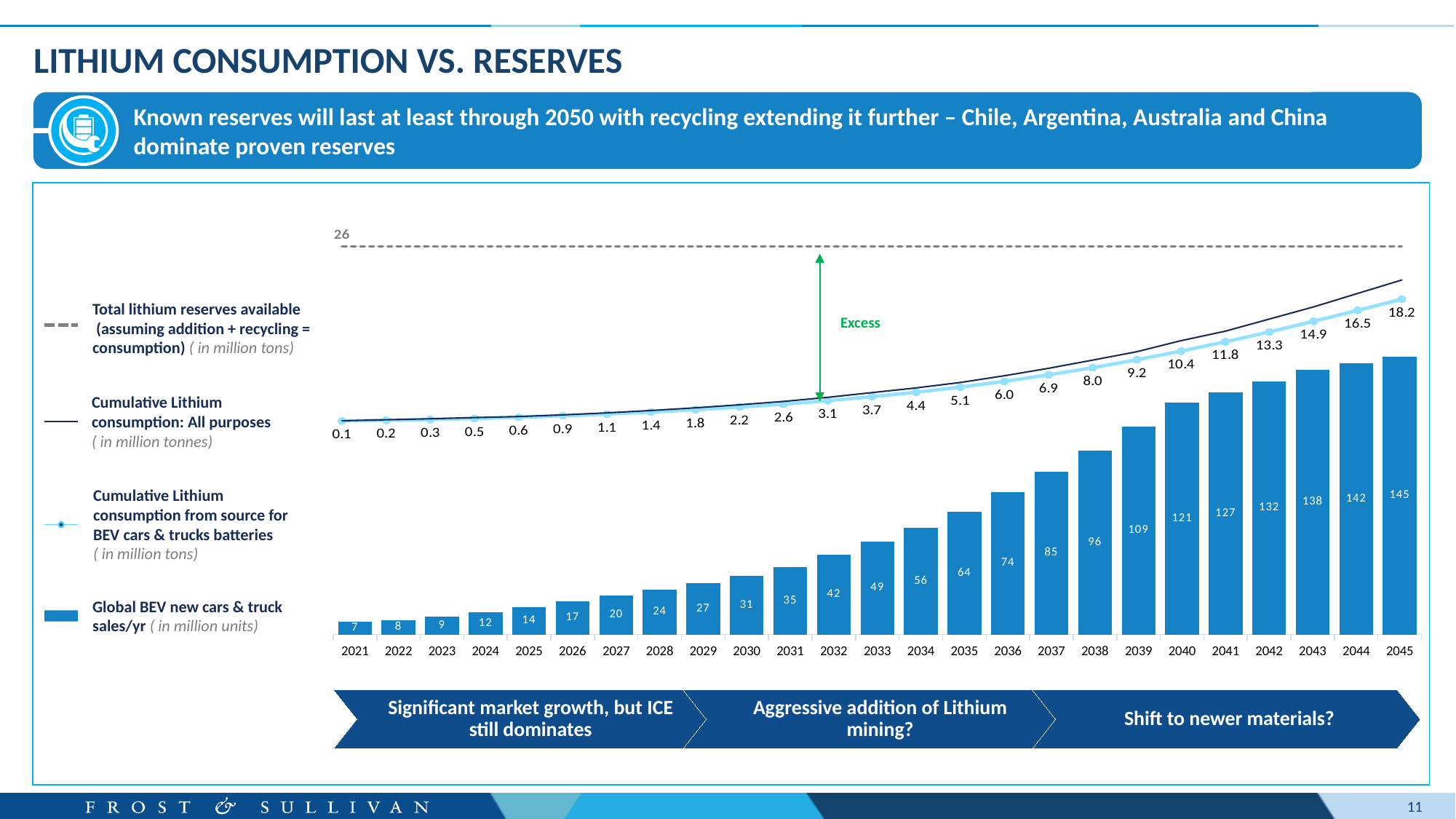
Which is larger: Global BEV new cars & truck sales/yr in 2033 or in 2035? 2035 Do the Global BEV new cars & truck sales/yr values rise or fall from 2021 to 2045? rise Which year has the lowest Global BEV new cars & truck sales/yr? 2021 At what level is the dashed line for total lithium reserves available drawn? 26 What is the difference in Global BEV new cars & truck sales/yr between 2045 and 2040? 24 Which year has the highest Global BEV new cars & truck sales/yr? 2045 What is the cumulative lithium consumption from source for BEV cars & trucks batteries in 2045? 18.2 How many years are shown on the x axis of the chart? 25 What is the value of Global BEV new cars & truck sales/yr for 2030? 31 How many series does the chart legend list? 4 What is the cumulative lithium consumption from source for BEV cars & trucks batteries in 2036? 6.0 What is the value of Global BEV new cars & truck sales/yr for 2039? 109